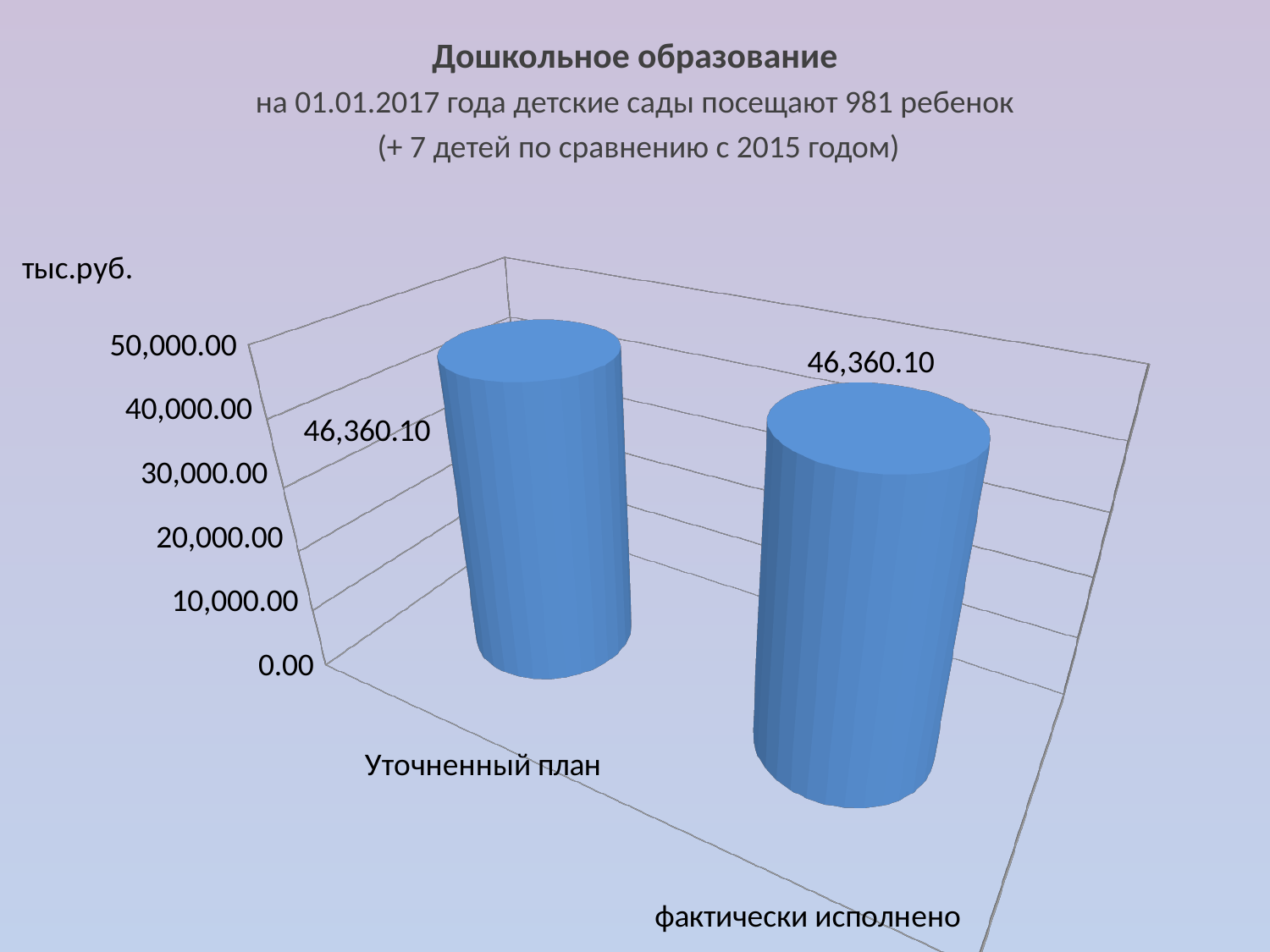
What is the value for фактически исполнено? 46,360.10 Is the value for Уточненный план greater or less than 40,000.00? greater What unit is shown for the vertical axis of the chart? тыс.руб. What is the highest tick value shown on the vertical axis? 50,000.00 What is the difference between the values for Уточненный план and фактически исполнено? 0.00 How many categories are plotted on the chart? 2 What is the title of the slide containing the chart? Дошкольное образование Is the value for фактически исполнено greater or less than 50,000.00? less What is the value for Уточненный план? 46,360.10 Are the values for Уточненный план and фактически исполнено equal? Yes What kind of chart is shown on the slide? bar chart